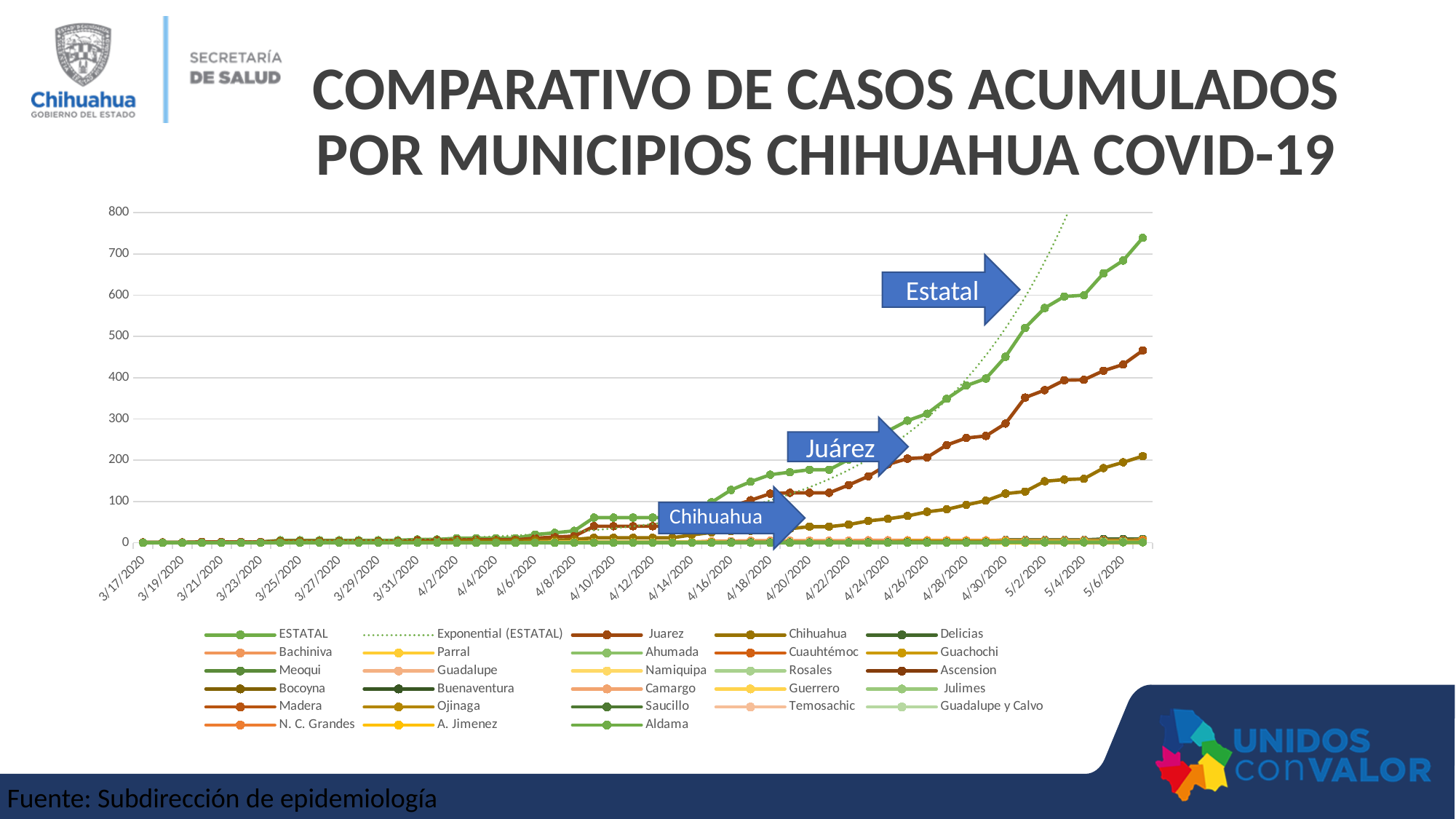
Is the final value of the Juarez series greater or less than 500? less Do the values of the ESTATAL series rise or fall along the x axis? rise What kind of chart is shown on the slide? line chart Is the final value of the Juarez series greater or less than 400? greater How many series does the legend list? 28 Is the final value of the ESTATAL series greater or less than 700? greater At the last date on the chart, which is larger: the Juarez series or the Chihuahua series? Juarez What is the title of the slide's chart? COMPARATIVO DE CASOS ACUMULADOS POR MUNICIPIOS CHIHUAHUA COVID-19 What is the first date shown on the x axis? 3/17/2020 Which legend entry is drawn as a dotted line? Exponential (ESTATAL) Which series reaches the highest value at the right end of the chart? ESTATAL